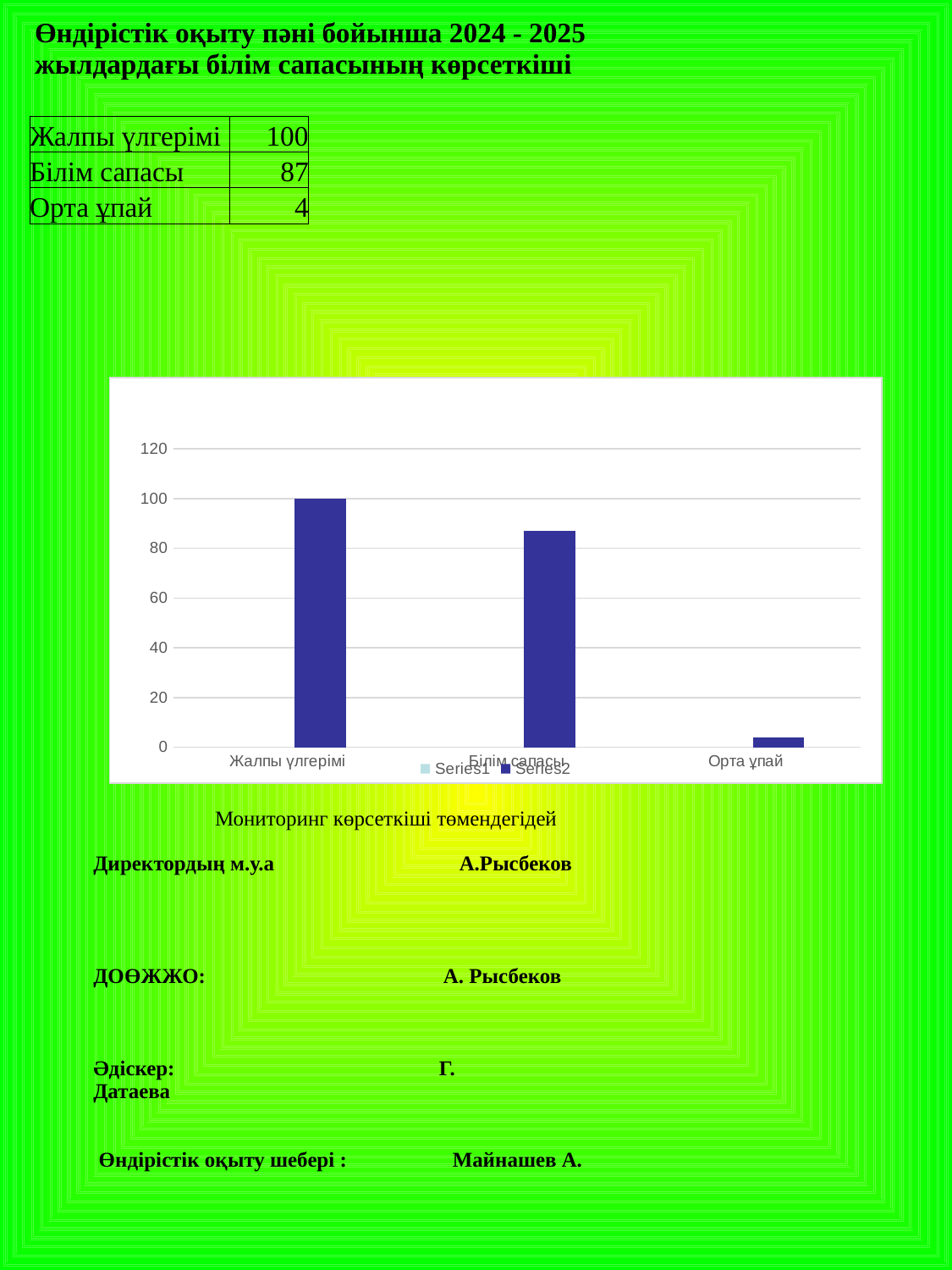
How many series does the chart legend list? 2 Which category has the lowest bar in the chart? Орта ұпай How many categories are shown on the x axis of the chart? 3 What is the value for Жалпы үлгерімі? 100 Which is larger, the bar for Білім сапасы or the bar for Орта ұпай? Білім сапасы What is the difference between the values for Жалпы үлгерімі and Білім сапасы? 13 What kind of chart is shown on the slide? bar chart Is the value for Білім сапасы greater or less than 80? greater What is the value for Білім сапасы? 87 Which category has the highest bar in the chart? Жалпы үлгерімі Do the bar values rise or fall from left to right along the x axis? fall What is the value for Орта ұпай? 4